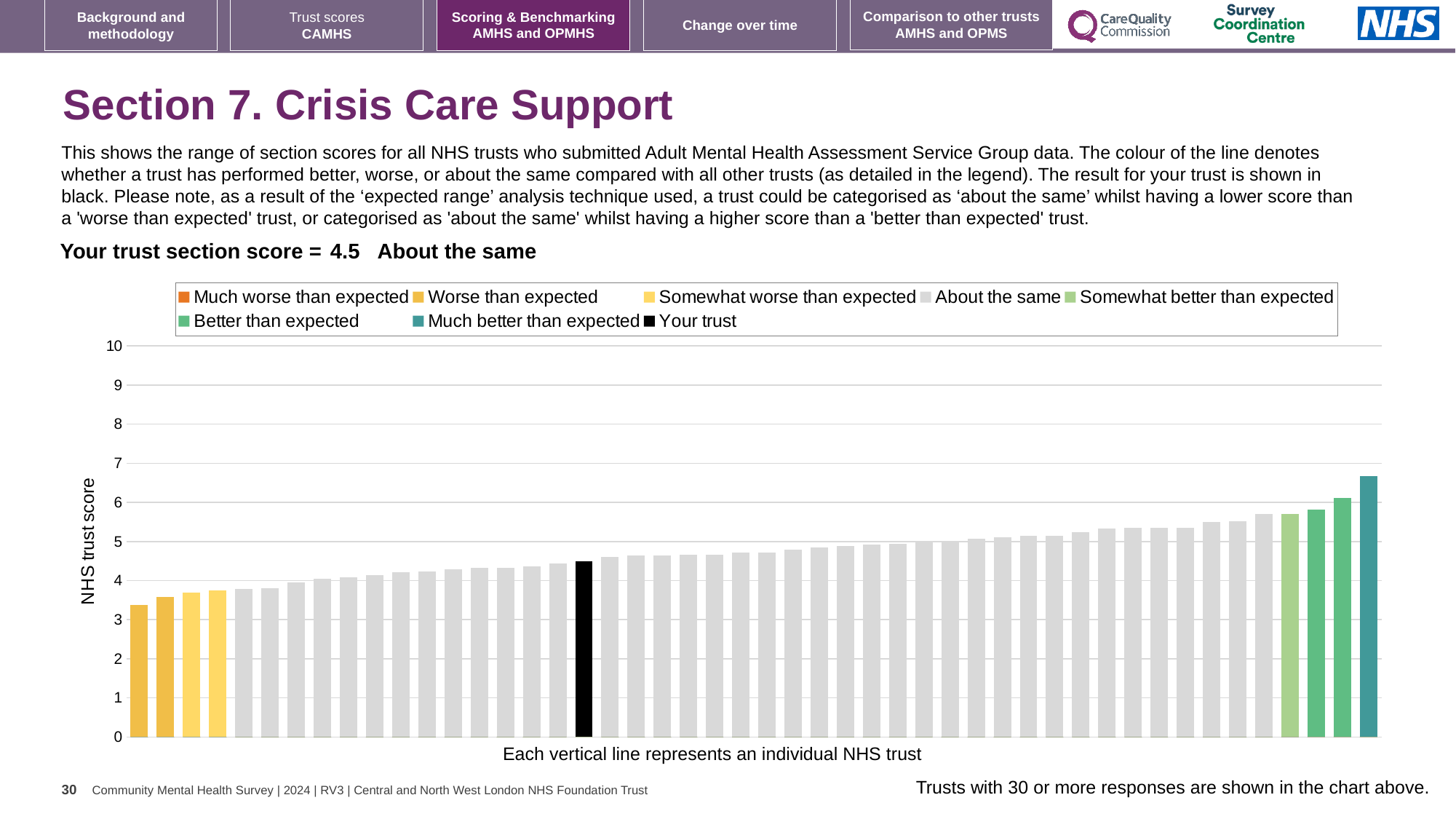
Is the value of the black 'Your trust' bar greater or less than 4? greater How many bars are coloured as 'Better than expected' (green)? 2 Is the value of the tallest bar in the chart greater or less than 6? greater Which legend category does the tallest bar (far right) belong to? Much better than expected What kind of chart is shown on the slide? Bar chart Is the value of the shortest bar in the chart greater or less than 3? greater Which performance category is your trust placed in for this section? About the same What is the section score for your trust shown on the slide? 4.5 Do the bar values rise or fall from left to right across the chart? rise What is the label on the vertical axis of the chart? NHS trust score How many bars are coloured as 'Worse than expected' (dark yellow)? 2 How many entries does the chart legend list? 8